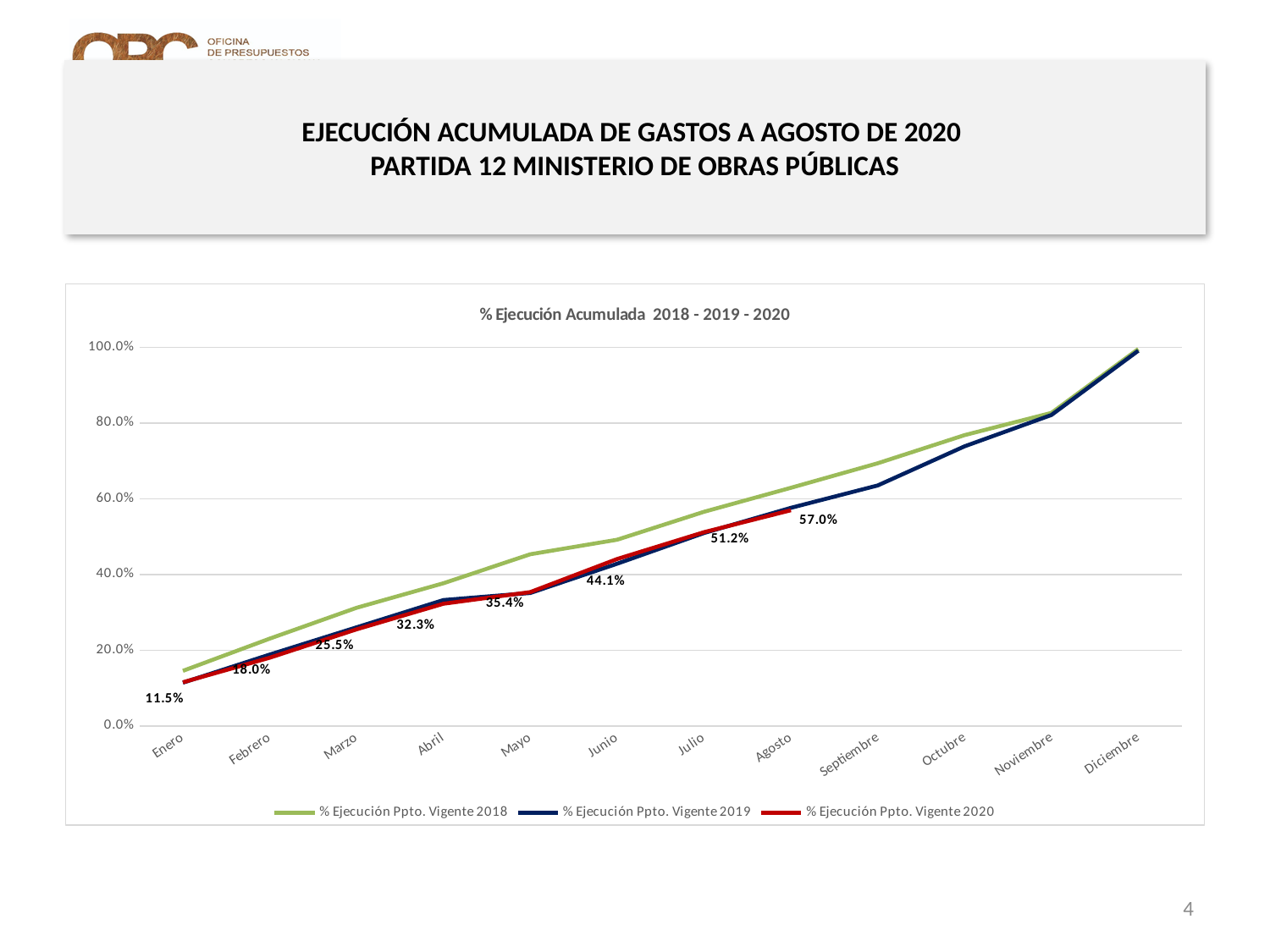
What is the difference between the 2020 values for Febrero and Enero? 6.5% How many series does the legend list? 3 Is the value for % Ejecución Ppto. Vigente 2019 in Octubre greater or less than 80.0%? less What is the difference between the 2020 values for Agosto and Julio? 5.8% What is the value for % Ejecución Ppto. Vigente 2020 in Junio? 44.1% What is the value for % Ejecución Ppto. Vigente 2020 in Enero? 11.5% Do the values for % Ejecución Ppto. Vigente 2020 rise or fall from Enero to Agosto? Rise How many months are shown on the x axis? 12 Is the value for % Ejecución Ppto. Vigente 2018 in Diciembre greater or less than 80.0%? greater What is the value for % Ejecución Ppto. Vigente 2020 in Agosto? 57.0% What kind of chart is shown? Line chart What is the value for % Ejecución Ppto. Vigente 2020 in Mayo? 35.4%